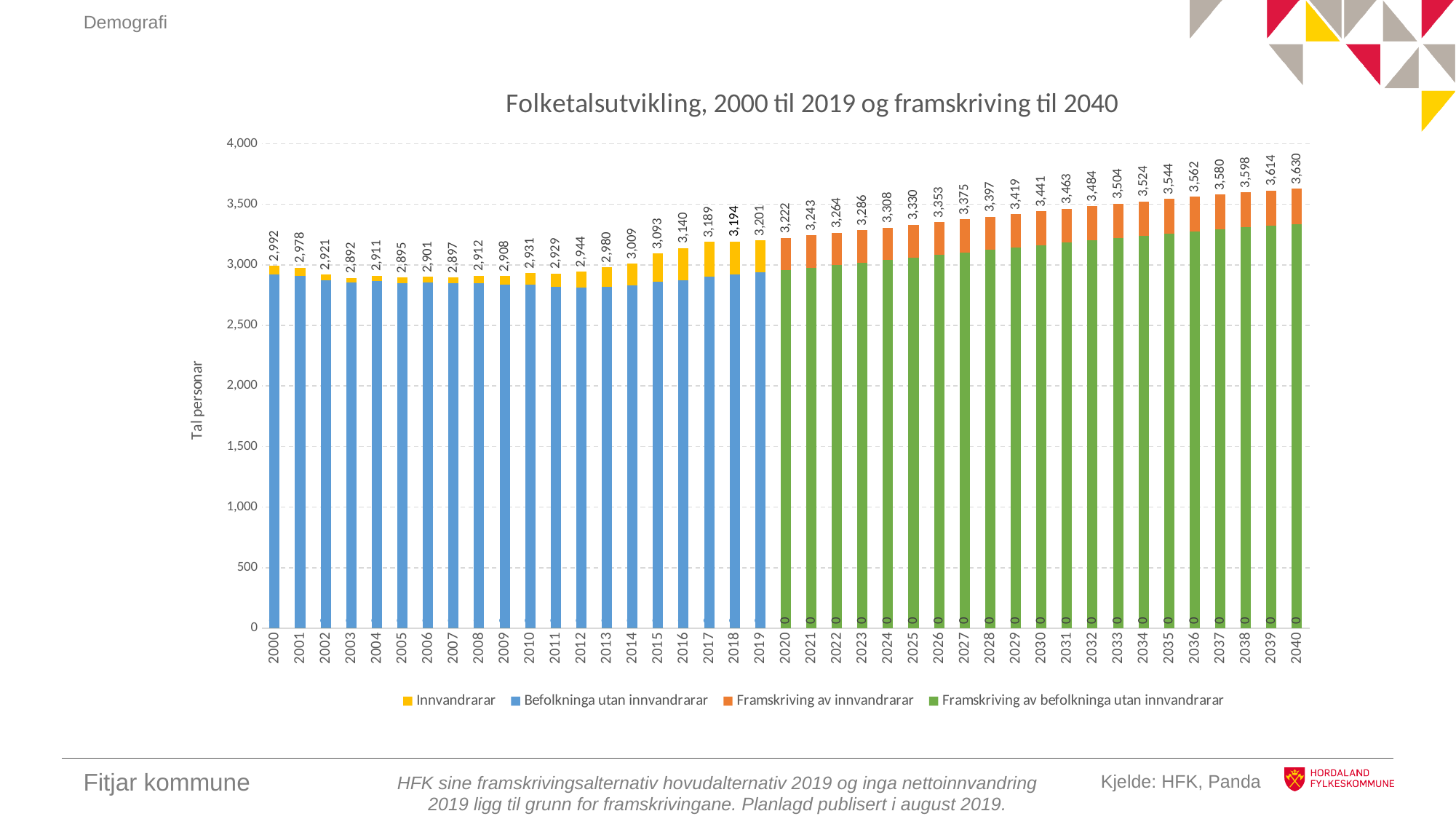
What is the difference between the total for 2019 and the total for 2000? 209 How many years (bars) are shown on the x axis? 41 What is the total population shown for 2000? 2,992 What is the projected total population for 2040? 3,630 What kind of chart is shown on the slide? Stacked bar chart Which year has the lowest total population in the chart? 2003 Which year has the highest total population in the chart? 2040 What is the total population shown for 2019? 3,201 How many series does the legend list? 4 Which year has a larger total population, 2010 or 2011? 2010 Is the total for 2015 greater or less than 3,000? greater What is the difference between the total for 2040 and the total for 2000? 638